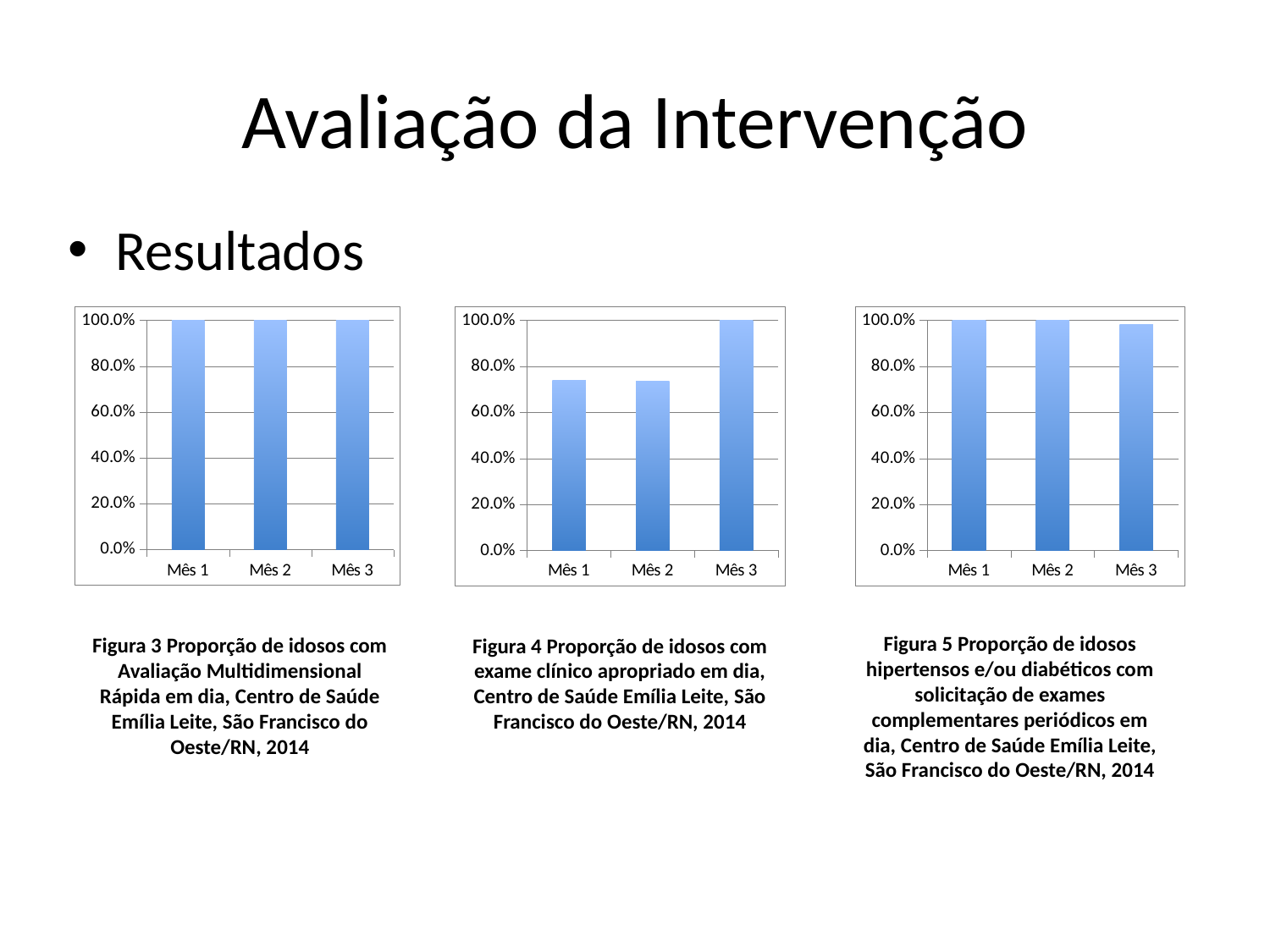
In the chart for Figura 4 (middle), what is the value for Mês 3? 100.0% In the chart for Figura 5 (right), is the value for Mês 3 greater or less than 80.0%? greater How many charts are shown on the slide? 3 What is the title of the slide? Avaliação da Intervenção What kind of chart is used for Figura 5 (right)? Bar chart In the chart for Figura 4 (middle), is the value for Mês 1 greater or less than 60.0%? greater In the chart for Figura 3 (left), what is the value for Mês 1? 100.0% In the chart for Figura 4 (middle), which is larger, the value for Mês 1 or the value for Mês 3? Mês 3 In the chart for Figura 5 (right), what is the value for Mês 2? 100.0% How many categories are shown on the x axis of the chart for Figura 3 (left)? 3 In the chart for Figura 4 (middle), is the value for Mês 2 greater or less than 80.0%? less In the chart for Figura 4 (middle), which month has the highest value? Mês 3